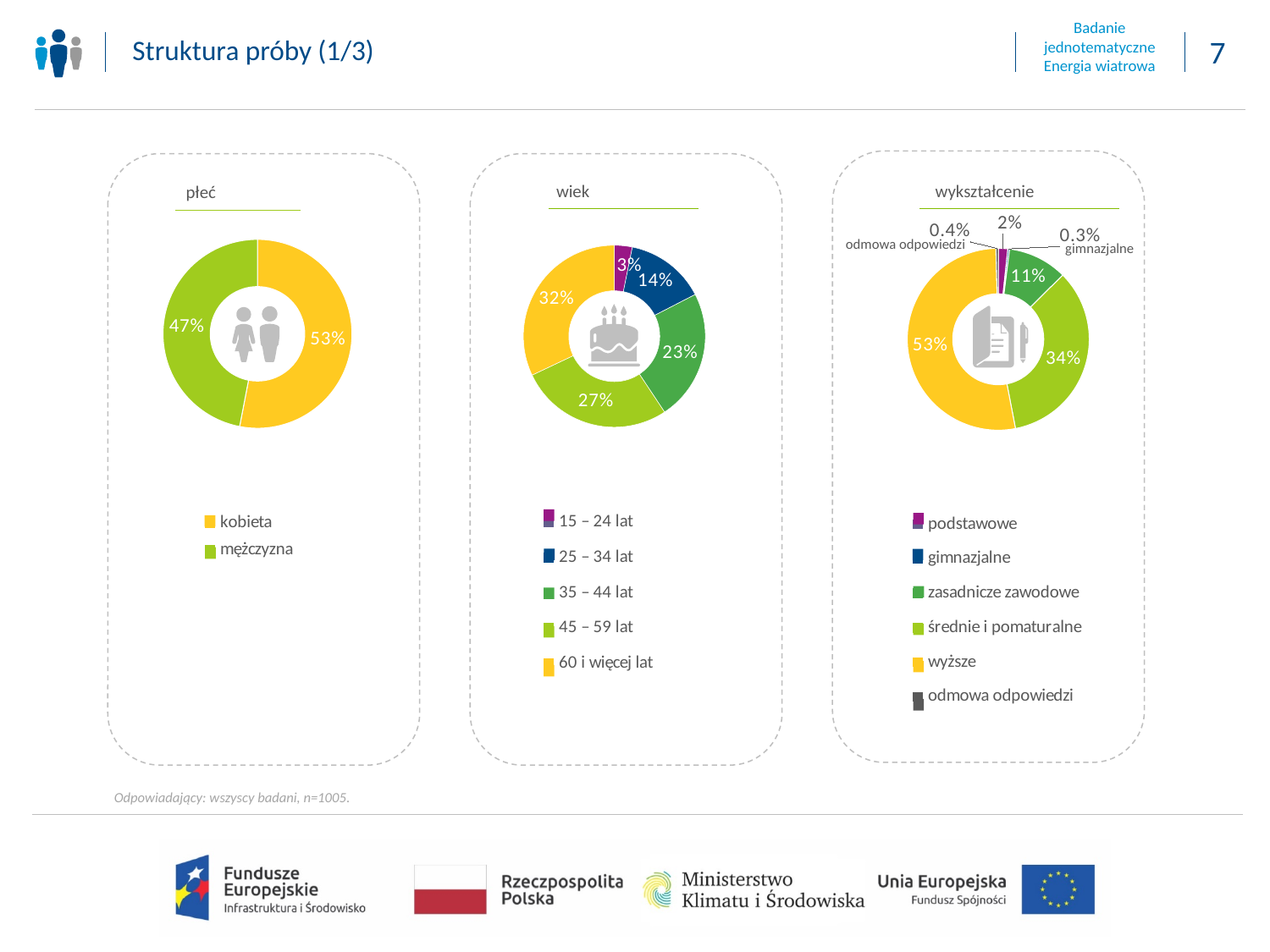
What type of chart is used for 'wykształcenie'? Donut (pie) chart In the 'wiek' chart, what percentage is shown for 25 – 34 lat? 14% In the 'wiek' chart, how many age groups does the legend list? 5 In the 'płeć' chart, what is the difference between the kobieta and mężczyzna shares? 6% In the 'wykształcenie' chart, what percentage is shown for gimnazjalne? 0.3% In the 'wykształcenie' chart, what percentage is shown for odmowa odpowiedzi? 0.4% In the 'płeć' chart, what percentage is shown for mężczyzna? 47% In the 'wykształcenie' chart, what percentage is shown for wyższe? 53% In the 'płeć' chart, what percentage is shown for kobieta? 53% In the 'wiek' chart, what percentage is shown for 60 i więcej lat? 32% In the 'wiek' chart, which age group has the smallest share? 15 – 24 lat In the 'wiek' chart, which is larger: 35 – 44 lat or 45 – 59 lat? 45 – 59 lat